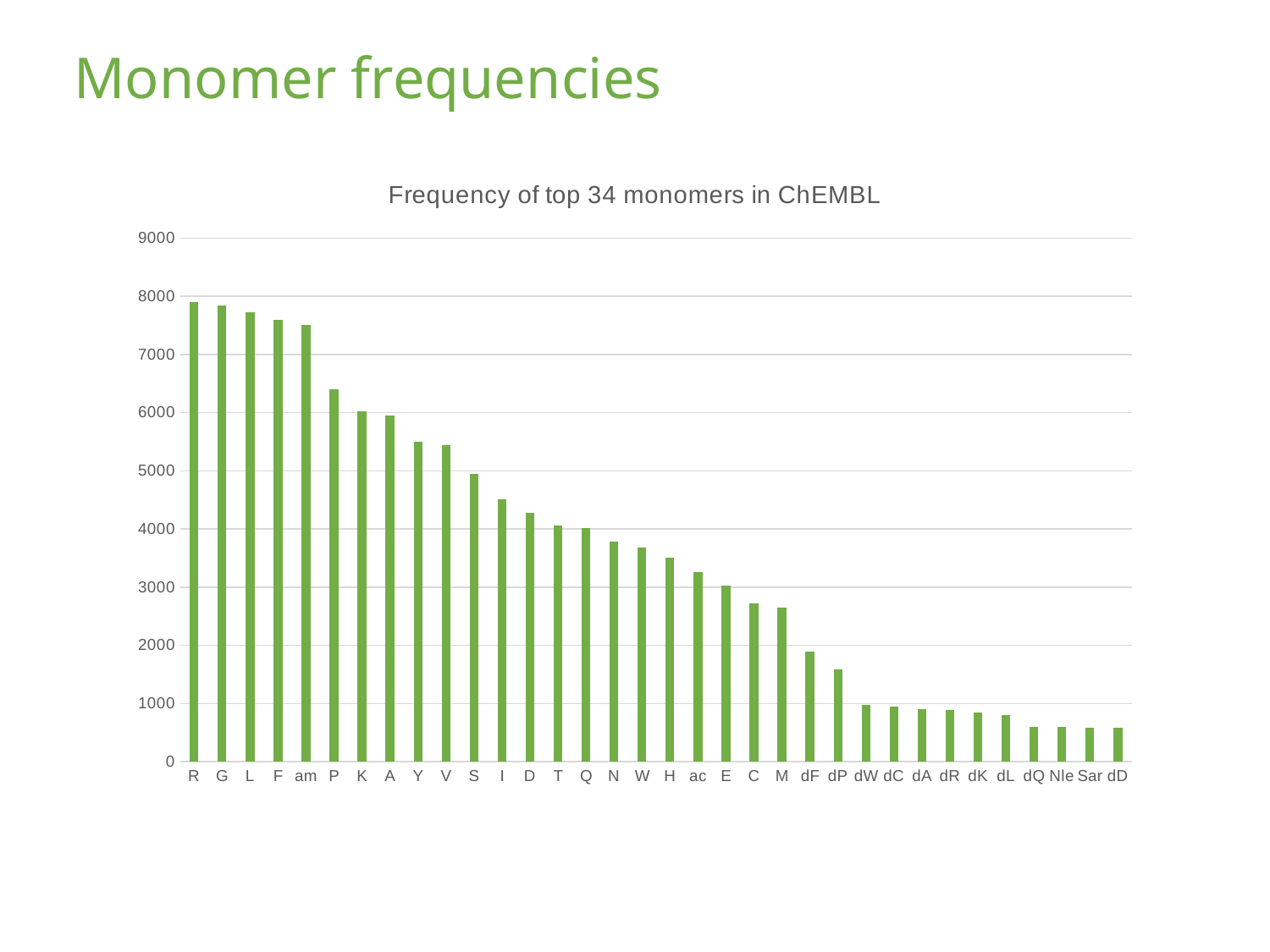
Is the value for dP greater or less than 1000? greater Do the bar values rise or fall moving from left to right along the x axis? fall Is the value for R greater or less than 7000? greater Is the value for M greater or less than 3000? less Which monomer has the highest frequency? R What is the title of the chart? Frequency of top 34 monomers in ChEMBL How many monomers (categories) are plotted on the x axis? 34 What kind of chart is shown on the slide? bar chart Which has the larger value, dF or dP? dF Which has the larger value, R or P? R